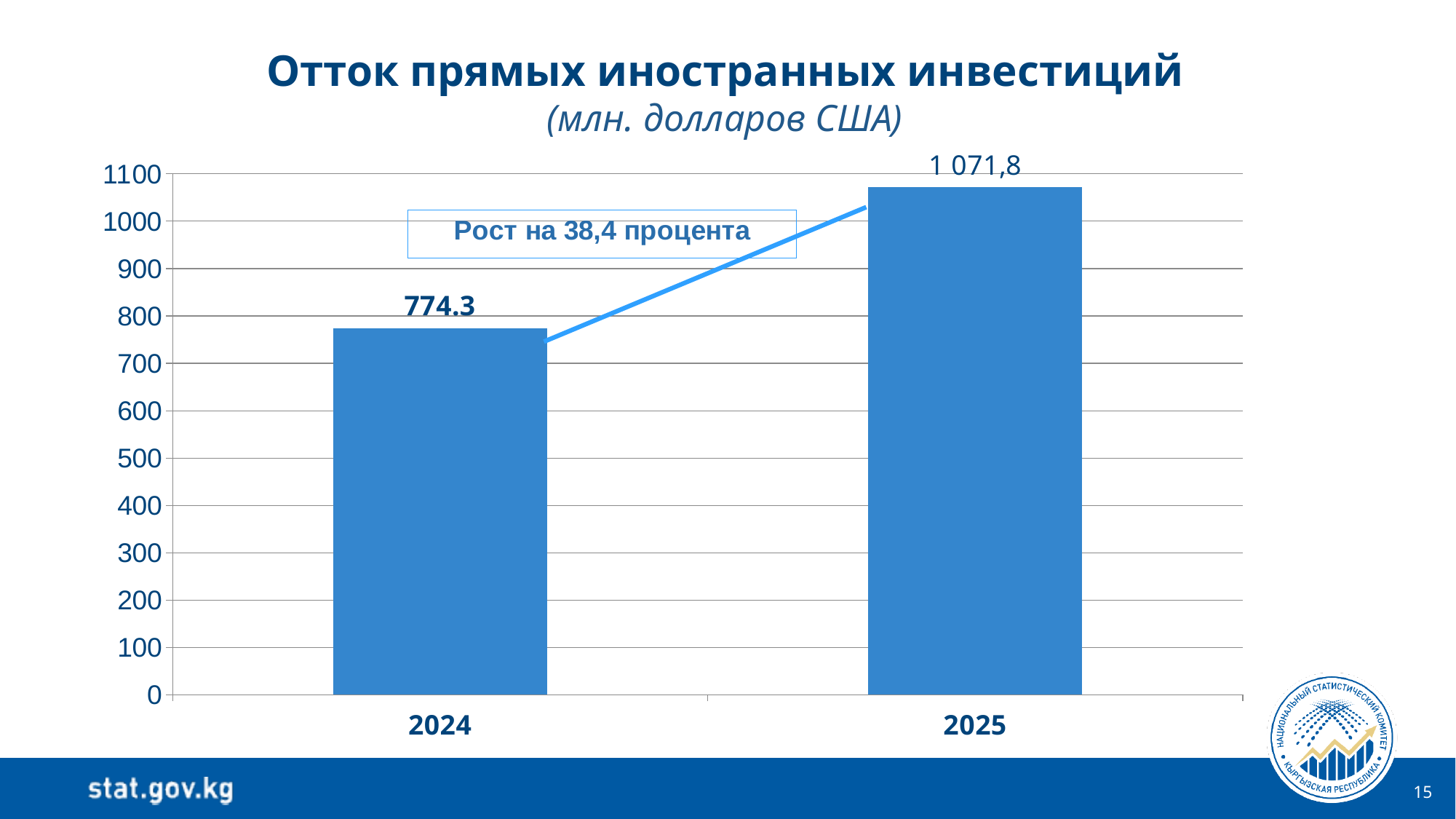
Is the value for 2024 larger or smaller than the value for 2025? smaller Which year has the lower value? 2024 What is the difference between the 2025 and 2024 values? 297.5 Is the value for 2024 greater or less than 800? less What is the value for 2024? 774.3 What is the value for 2025? 1 071,8 Do the values rise or fall from 2024 to 2025? rise What kind of chart is shown on the slide? bar chart How many bars are shown in the chart? 2 Which year has the higher value? 2025 Is the value for 2025 greater or less than 1000? greater What percentage growth does the annotation on the chart state? 38,4 процента